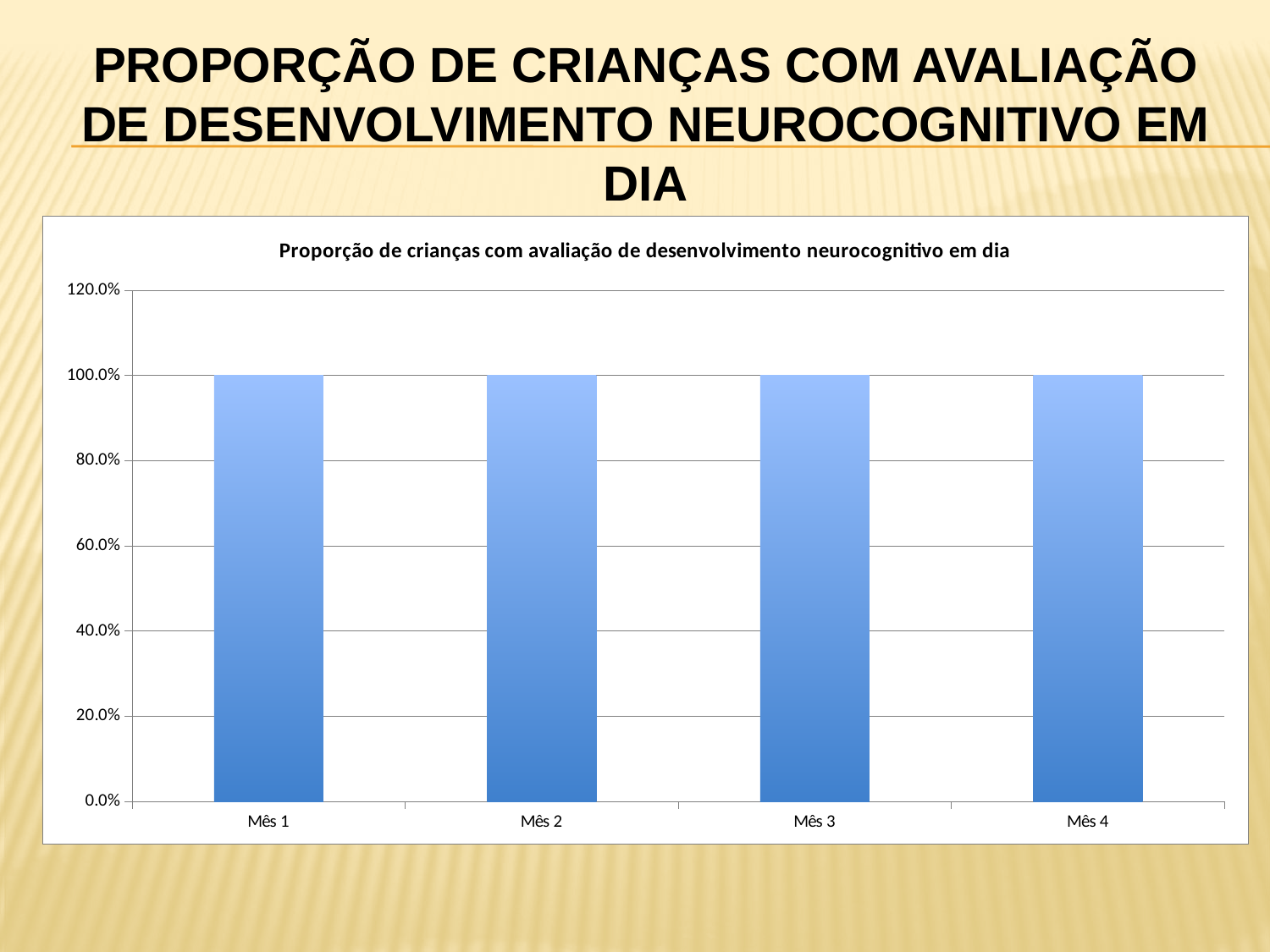
What is the highest value shown on the y axis of the chart? 120.0% What is the value for Mês 4? 100.0% Is the value for Mês 3 greater or less than 80.0%? greater What is the value for Mês 3? 100.0% How many categories (months) are shown on the x axis of the chart? 4 Is the value for Mês 1 greater or less than 120.0%? less What is the difference between the values for Mês 2 and Mês 4? 0.0% What type of chart is shown on the slide? bar chart What is the title of the chart? Proporção de crianças com avaliação de desenvolvimento neurocognitivo em dia Do the values rise, fall, or stay the same from Mês 1 to Mês 4? stay the same What is the value for Mês 1? 100.0% What is the value for Mês 2? 100.0%